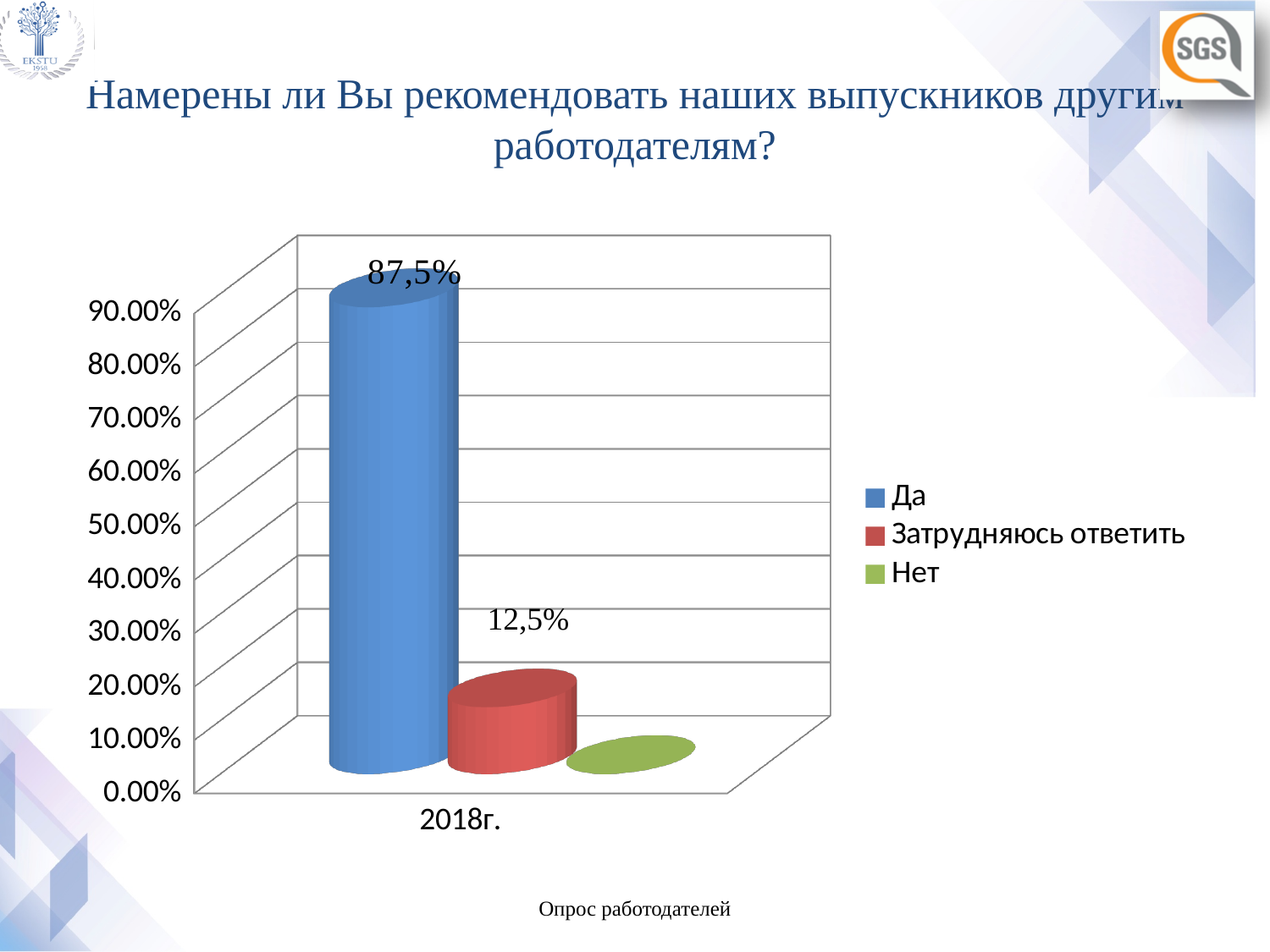
Is the value for "Нет" greater or less than 10.00%? less Which series has the lowest value in 2018г.? Нет What is the difference between the values for "Да" and "Затрудняюсь ответить"? 75% How many series does the legend list? 3 How many categories are shown on the x axis? 1 What is the value for "Затрудняюсь ответить" in 2018г.? 12,5% What is the value for "Да" in 2018г.? 87,5% Which is larger, the value for "Да" or the value for "Затрудняюсь ответить"? Да Which series has the highest value in 2018г.? Да Which colour represents the "Нет" series in the legend? Green Is the value for "Да" greater or less than 80.00%? greater What kind of chart is shown on the slide? Bar chart